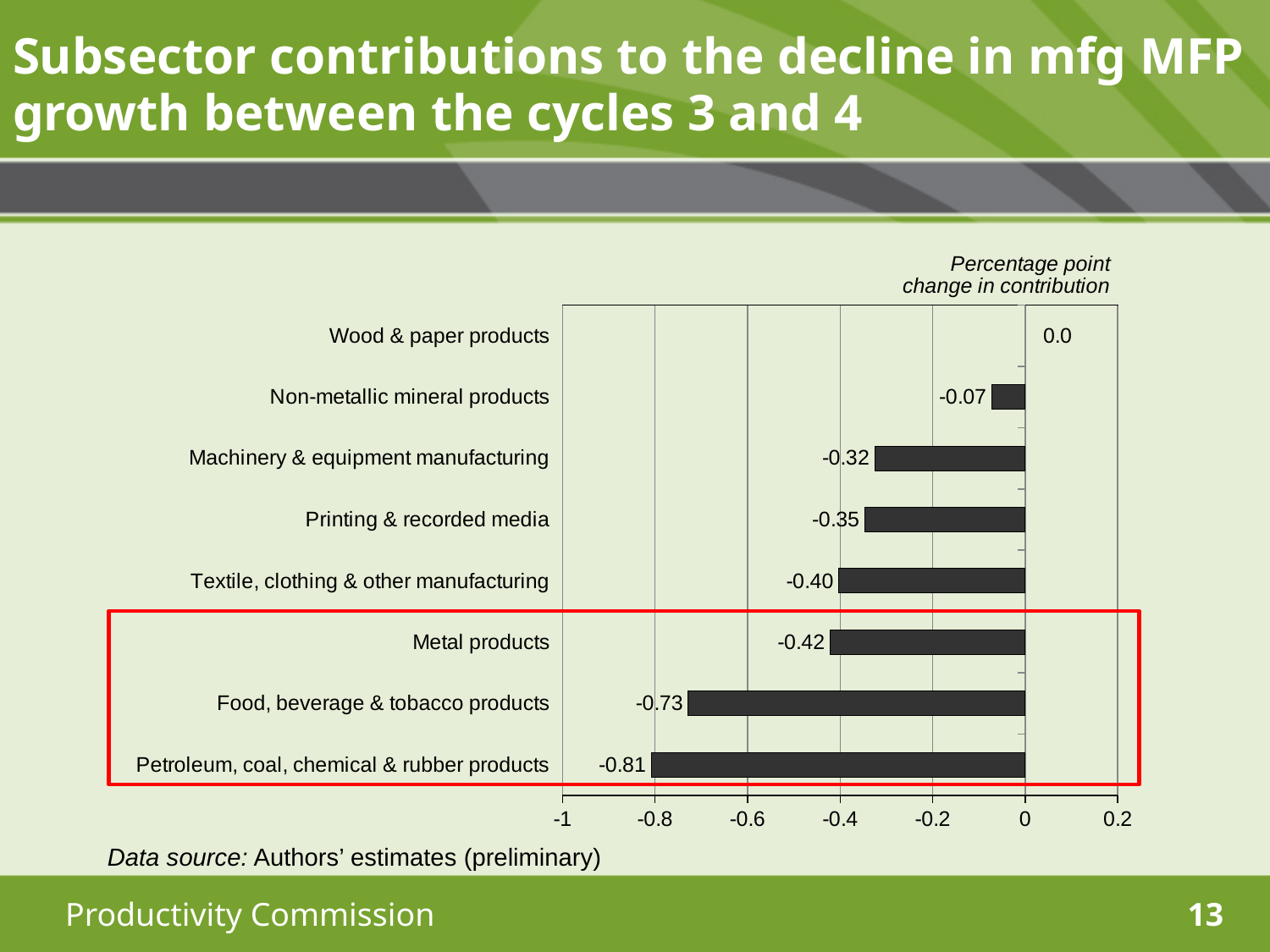
Which subsector has the lowest (most negative) value? Petroleum, coal, chemical & rubber products What is the value for Petroleum, coal, chemical & rubber products? -0.81 Is the value for Food, beverage & tobacco products greater or less than -0.6? less What is the value for Food, beverage & tobacco products? -0.73 Which subsector has the highest value? Wood & paper products What is the difference between the values for Food, beverage & tobacco products and Petroleum, coal, chemical & rubber products? 0.08 What is the value for Wood & paper products? 0.0 What is the value for Non-metallic mineral products? -0.07 What kind of chart is shown on the slide? bar chart How many subsectors are shown in the chart? 8 Which is larger, the value for Machinery & equipment manufacturing or the value for Printing & recorded media? Machinery & equipment manufacturing What unit label is shown above the chart's axis? Percentage point change in contribution